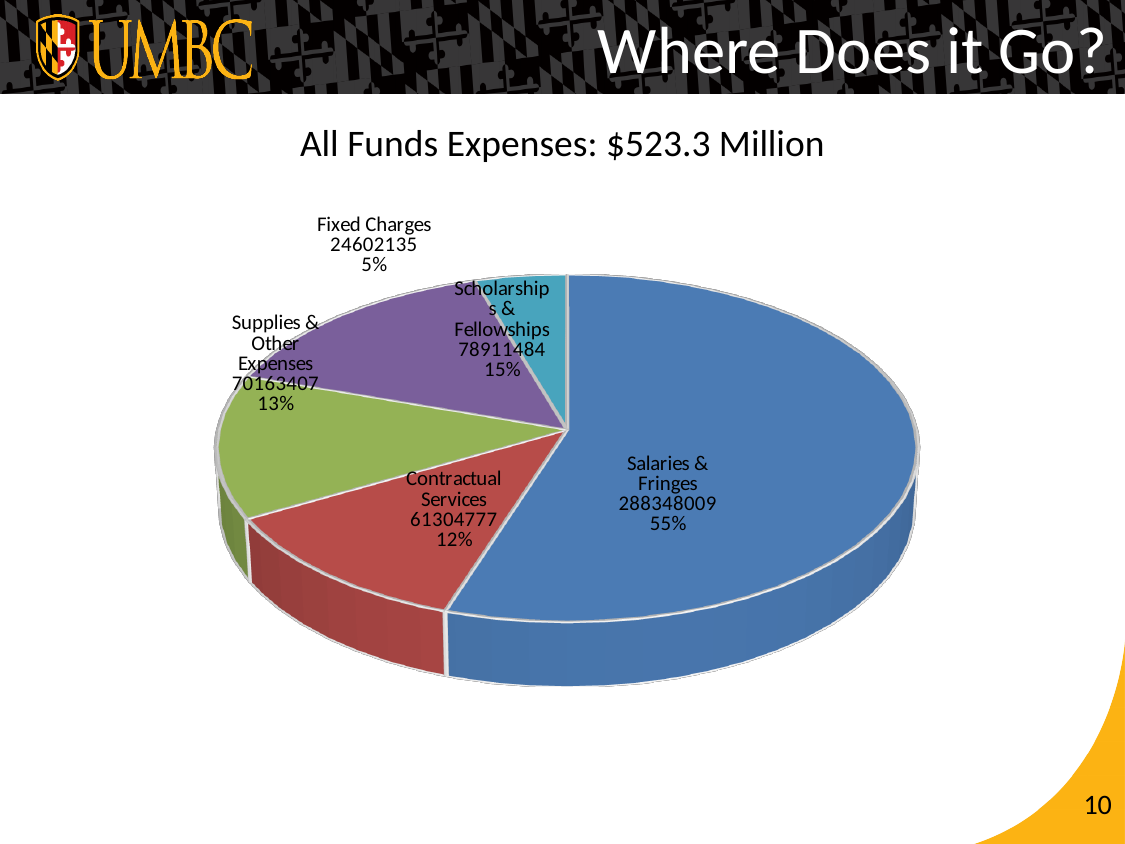
What is the value for Contractual Services? 61304777 What kind of chart is shown on the slide? Pie chart What is the value for Salaries & Fringes? 288348009 What is the title of the chart? All Funds Expenses: $523.3 Million What is the value for Fixed Charges? 24602135 What share of the pie is Scholarships & Fellowships? 15% What is the difference between the values for Scholarships & Fellowships and Supplies & Other Expenses? 8748077 What share of the pie is Salaries & Fringes? 55% Which category has the smallest slice? Fixed Charges Which category has the largest slice? Salaries & Fringes Which is larger, Supplies & Other Expenses or Contractual Services? Supplies & Other Expenses How many slices does the pie chart have? 5